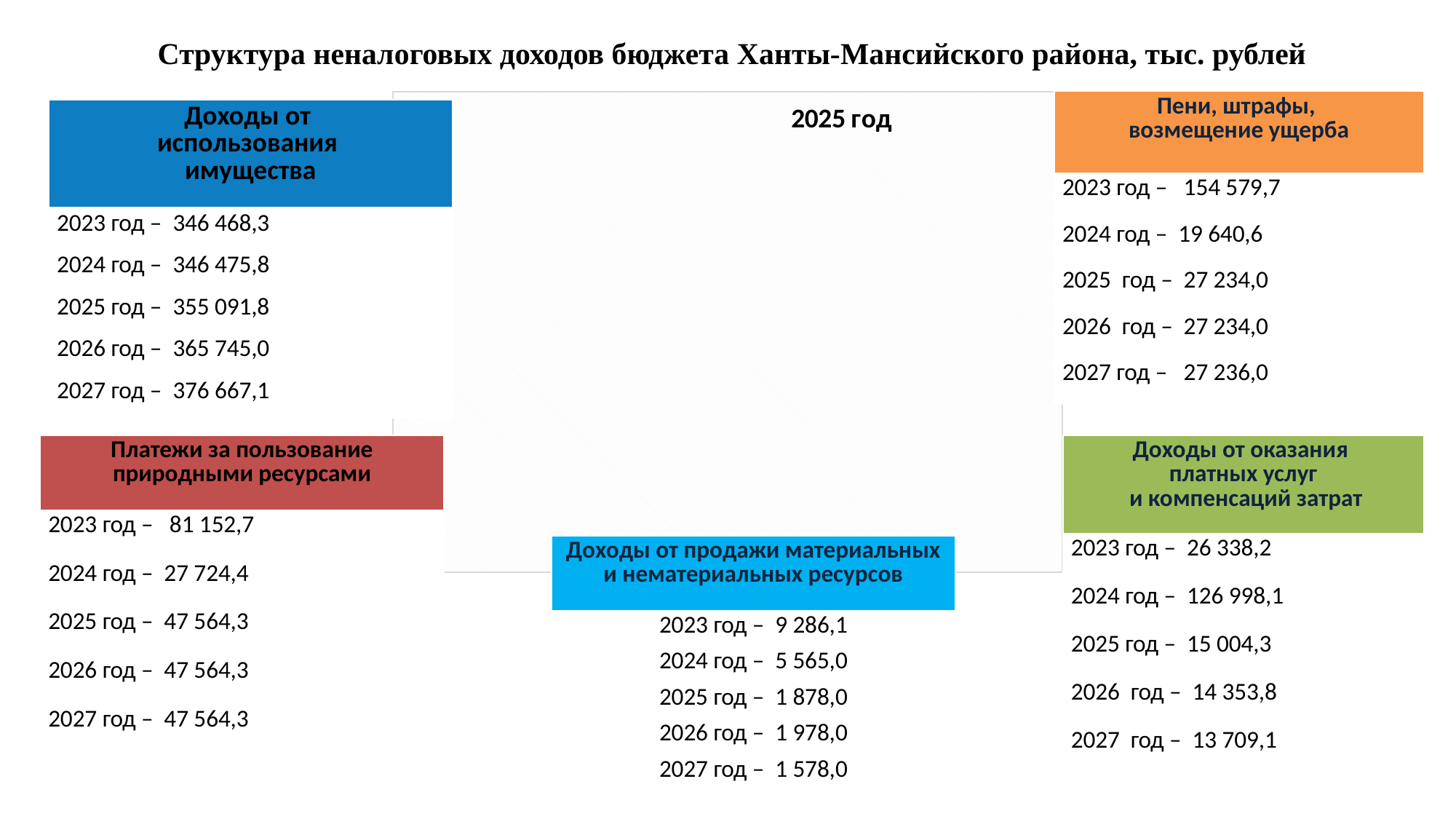
Do the values for "Доходы от использования имущества" rise or fall from 2023 год to 2027 год? rise What value is shown for 2025 год under "Доходы от использования имущества"? 355 091,8 Which category has the highest value for 2025 год? Доходы от использования имущества For 2025 год, which is larger: "Платежи за пользование природными ресурсами" or "Пени, штрафы, возмещение ущерба"? Платежи за пользование природными ресурсами What is the overall title of the slide? Структура неналоговых доходов бюджета Ханты-Мансийского района, тыс. рублей What value is shown for 2025 год under "Платежи за пользование природными ресурсами"? 47 564,3 What value is shown for 2025 год under "Доходы от продажи материальных и нематериальных ресурсов"? 1 878,0 What value is shown for 2025 год under "Доходы от оказания платных услуг и компенсаций затрат"? 15 004,3 What title is shown at the top of the chart area in the centre of the slide? 2025 год What value is shown for 2025 год under "Пени, штрафы, возмещение ущерба"? 27 234,0 Which category has the lowest value for 2025 год? Доходы от продажи материальных и нематериальных ресурсов How many income categories are listed around the chart? 5